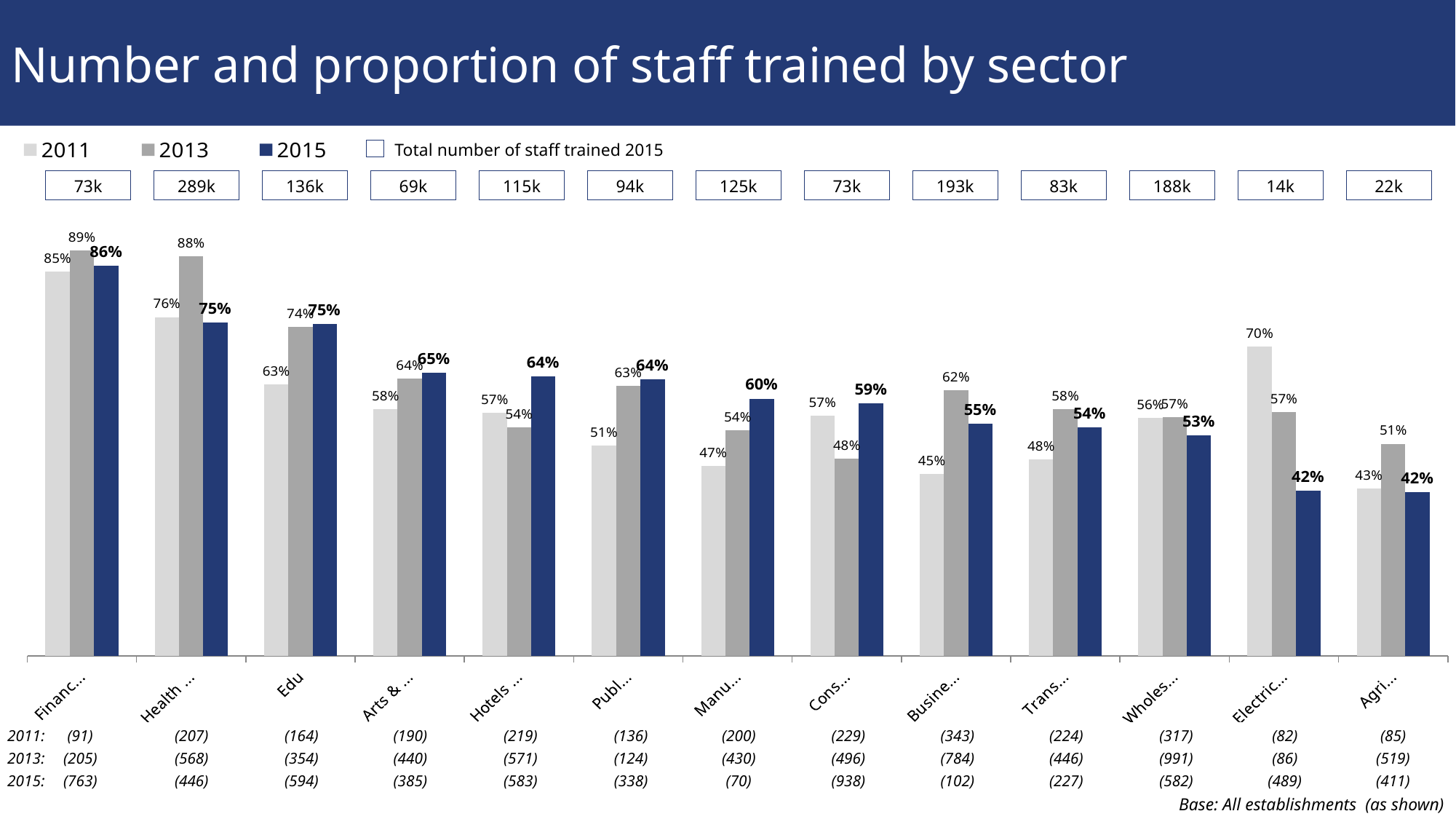
What is the 2011 value for the Edu sector? 63% What is the lowest 2015 value shown on the chart? 42% For the sector labelled 'Hotels ...', which is larger: the 2013 value or the 2015 value? 2015 For the Edu sector, what is the difference between the 2015 value and the 2011 value? 12 percentage points What is the total number of staff trained in 2015 shown in the box above the Edu sector? 136k What is the 2015 value for the Edu sector? 75% Do the 2015 values generally rise or fall moving from left to right across the sectors? fall How many sector categories are plotted along the x axis? 13 What is the title of the slide? Number and proportion of staff trained by sector How many years does the chart legend list as bar series? 3 What is the highest 2015 value shown on the chart? 86% What type of chart is shown on the slide? bar chart